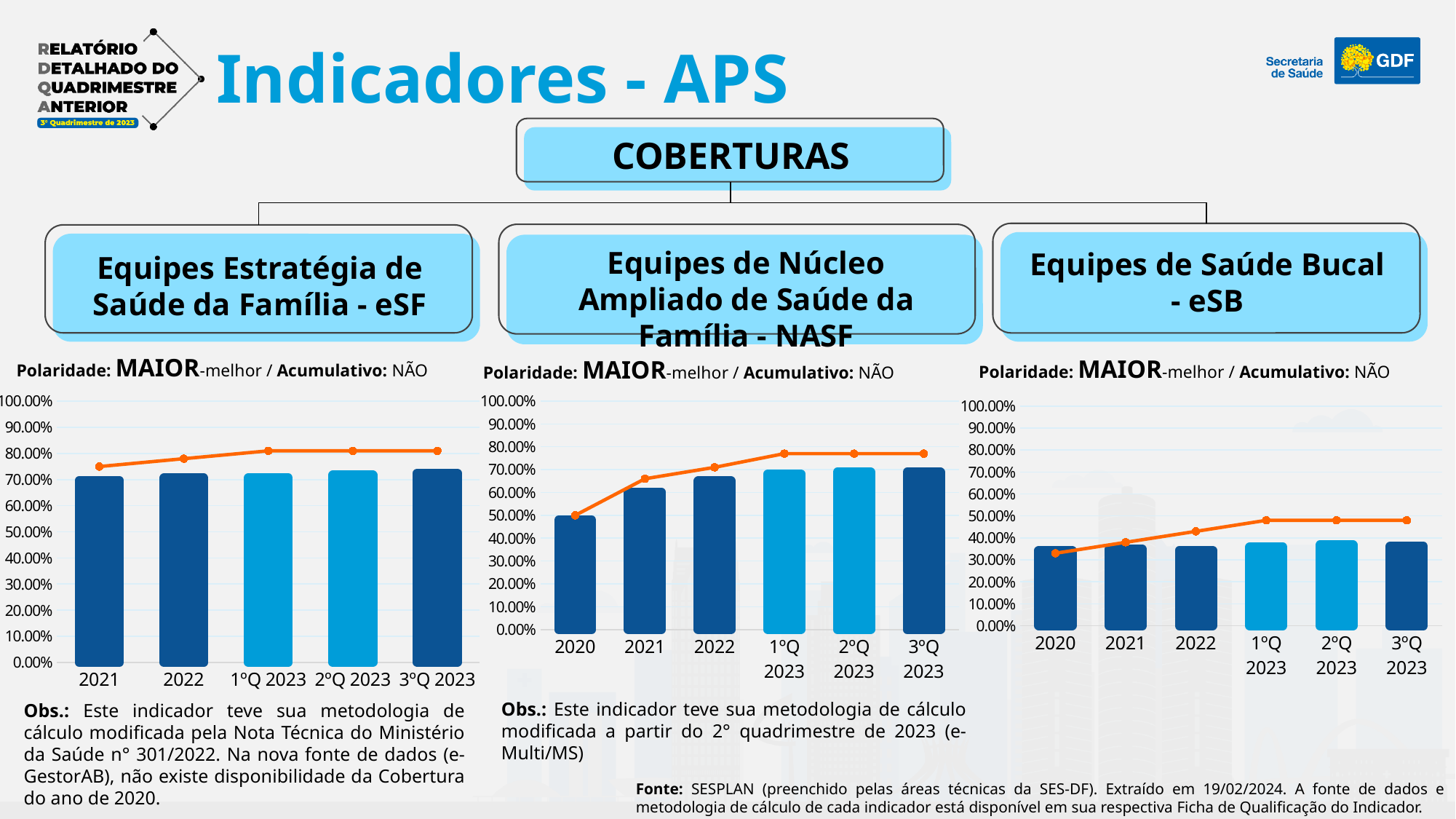
In the eSB chart (right), is the bar value for 2020 greater or less than 40.00%? less What is the polarity stated above each chart? MAIOR-melhor In the eSB chart (right), which is larger: the line value for 2020 or the line value for 3°Q 2023? 3°Q 2023 In the NASF chart (middle), do the bar values rise or fall from 2020 to 3°Q 2023? Rise In the eSB chart (right), is the line value for 3°Q 2023 greater or less than 40.00%? greater In the NASF chart (middle), how many categories are shown on the x axis? 6 In the NASF chart (middle), which category has the lowest bar? 2020 In the eSF chart (left), how many categories are shown on the x axis? 5 What kind of chart is the eSB chart (right)? Bar chart with a line How many charts are shown on the slide? 3 In the NASF chart (middle), is the bar value for 2020 greater or less than 60.00%? less